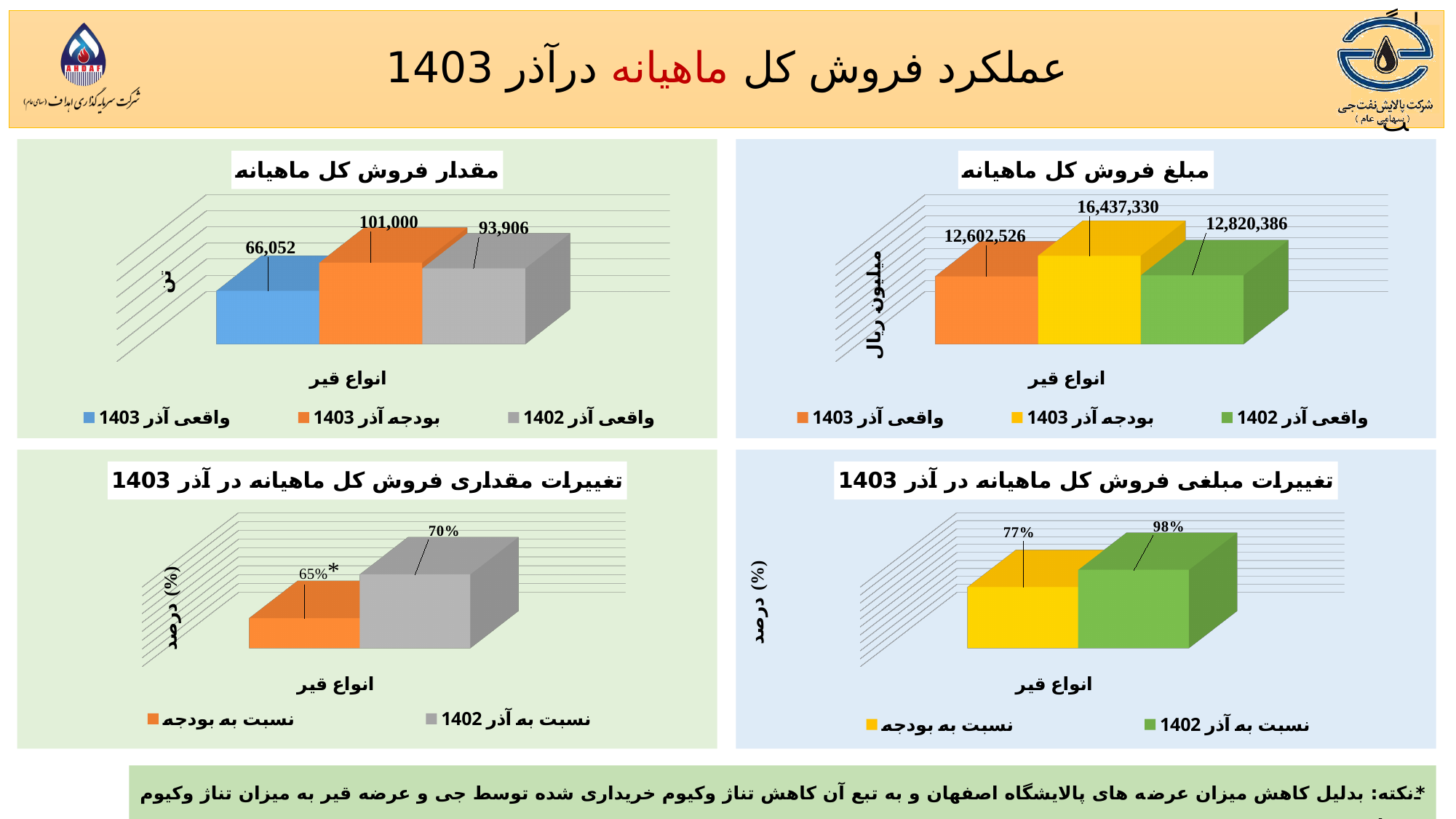
In the top-left chart titled «مقدار فروش کل ماهیانه», what is the value for «واقعی آذر 1403»? 66,052 In the top-left chart titled «مقدار فروش کل ماهیانه», what is the value for «بودجه آذر 1403»? 101,000 In the top-left chart titled «مقدار فروش کل ماهیانه», which series has the lowest value? واقعی آذر 1403 In the top-right chart titled «مبلغ فروش کل ماهیانه», what is the value for «واقعی آذر 1402»? 12,820,386 In the bottom-left chart titled «تغییرات مقداری فروش کل ماهیانه در آذر 1403», what is the value for «نسبت به بودجه»? 65% In the top-right chart titled «مبلغ فروش کل ماهیانه», which series has the highest value? بودجه آذر 1403 In the top-right chart titled «مبلغ فروش کل ماهیانه», how many series does the legend list? 3 In the top-left chart titled «مقدار فروش کل ماهیانه», what is the difference between «بودجه آذر 1403» and «واقعی آذر 1402»? 7,094 What kind of chart is the bottom-right chart titled «تغییرات مبلغی فروش کل ماهیانه در آذر 1403»? bar chart In the bottom-right chart titled «تغییرات مبلغی فروش کل ماهیانه در آذر 1403», which is larger: «نسبت به بودجه» or «نسبت به آذر 1402»? نسبت به آذر 1402 In the top-right chart titled «مبلغ فروش کل ماهیانه», what is the value for «بودجه آذر 1403»? 16,437,330 In the bottom-left chart titled «تغییرات مقداری فروش کل ماهیانه در آذر 1403», what is the value for «نسبت به آذر 1402»? 70%